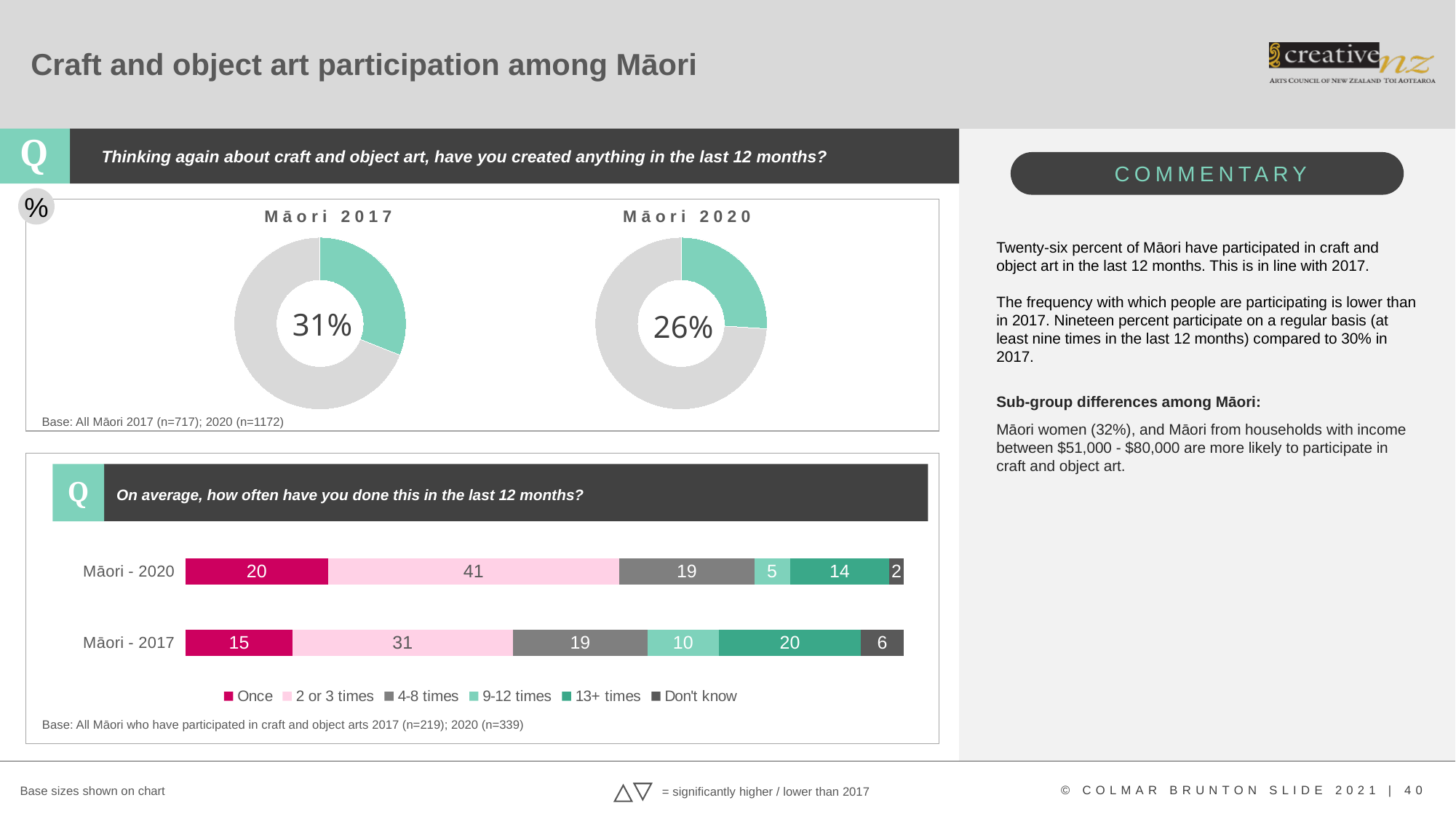
What type of chart is used to show how often people have done this in the last 12 months? Stacked bar chart In the Māori 2020 donut chart, what percentage is shown in the centre? 26% In the stacked bar chart on how often people have done this, what is the value for '2 or 3 times' for Māori - 2020? 41 In the stacked bar chart on how often people have done this, what is the value for 'Once' for Māori - 2020? 20 In the Māori 2017 donut chart, what percentage is shown in the centre? 31% In the stacked bar chart on how often people have done this, how many series does the legend list? 6 In the stacked bar chart on how often people have done this, what is the difference between the '9-12 times' values for Māori - 2017 and Māori - 2020? 5 In the stacked bar chart on how often people have done this, what is the value for '13+ times' for Māori - 2017? 20 What is the difference between the percentages shown in the Māori 2017 and Māori 2020 donut charts? 5 percentage points Comparing the two donut charts, which year shows the higher participation percentage, Māori 2017 or Māori 2020? Māori 2017 In the stacked bar chart on how often people have done this, which segment is the smallest for Māori - 2020? Don't know In the stacked bar chart on how often people have done this, which segment is the largest for Māori - 2017? 2 or 3 times